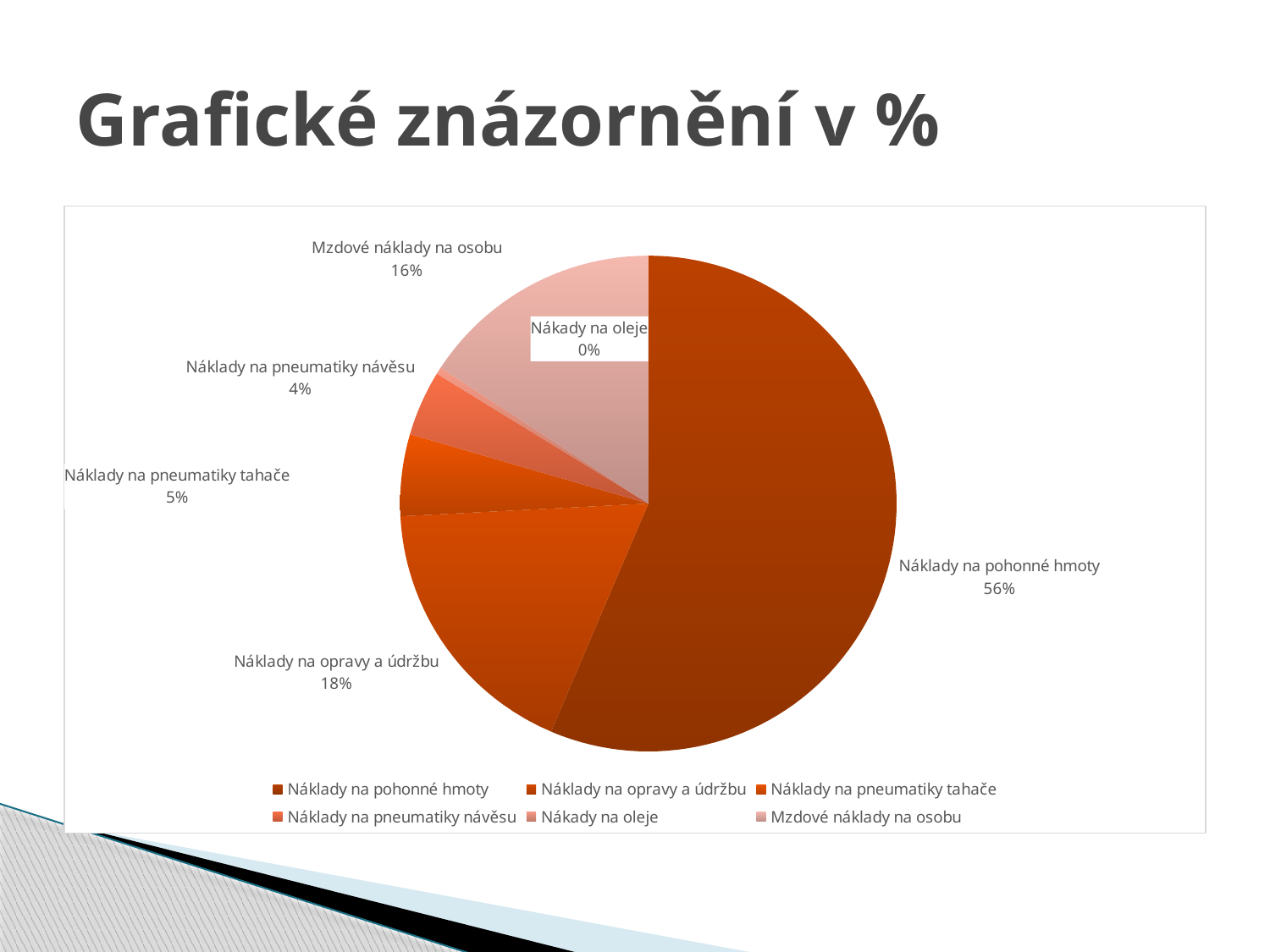
Which category has the smallest slice of the pie? Nákady na oleje What is the title of the slide containing the chart? Grafické znázornění v % What share of the pie does Náklady na opravy a údržbu have? 18% What share of the pie does Náklady na pohonné hmoty have? 56% Which is larger: Náklady na pneumatiky tahače or Náklady na pneumatiky návěsu? Náklady na pneumatiky tahače What is the difference in percentage points between Náklady na opravy a údržbu and Mzdové náklady na osobu? 2% Which category has the largest slice of the pie? Náklady na pohonné hmoty What share of the pie does Náklady na pneumatiky tahače have? 5% What kind of chart is shown on the slide? pie chart How many categories does the pie chart show? 6